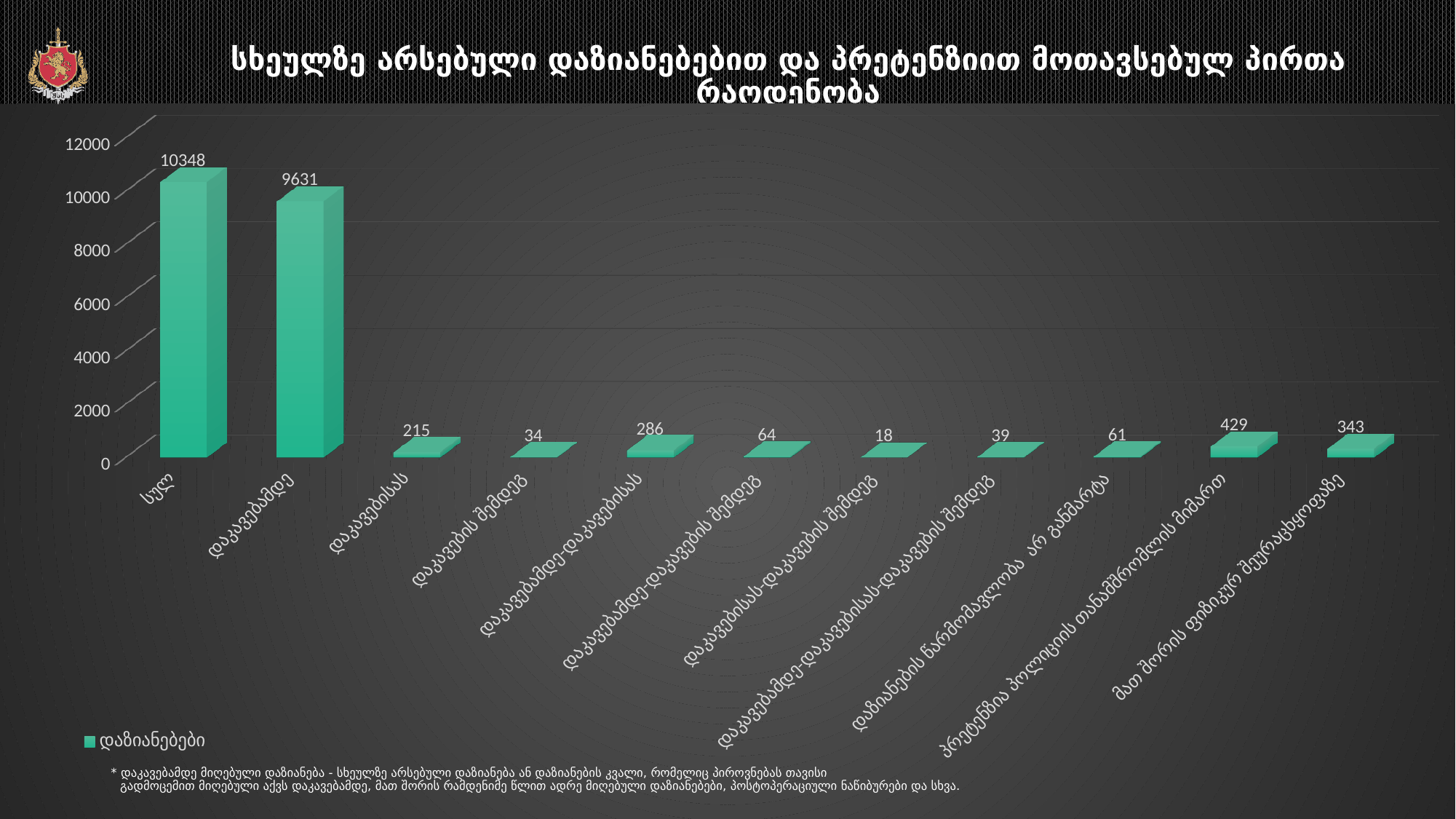
Which category has the highest value? სულ What is the difference between the values for "სულ" and "დაკავებამდე"? 717 Which category has the lowest value? დაკავებისას-დაკავების შემდეგ What is the value for the category "სულ"? 10348 How many series does the legend list? 1 How many categories are shown on the x axis? 11 What kind of chart is shown on the slide? Bar chart What is the legend entry for the series? დაზიანებები What is the value for the category "პრეტენზია პოლიციის თანამშრომლის მიმართ"? 429 What is the value for the category "მათ შორის ფიზიკურ შეურაცხყოფაზე"? 343 What is the value for the category "დაკავებამდე"? 9631 Which is larger, the value for "დაკავებისას" or the value for "დაკავებამდე-დაკავებისას"? დაკავებამდე-დაკავებისას